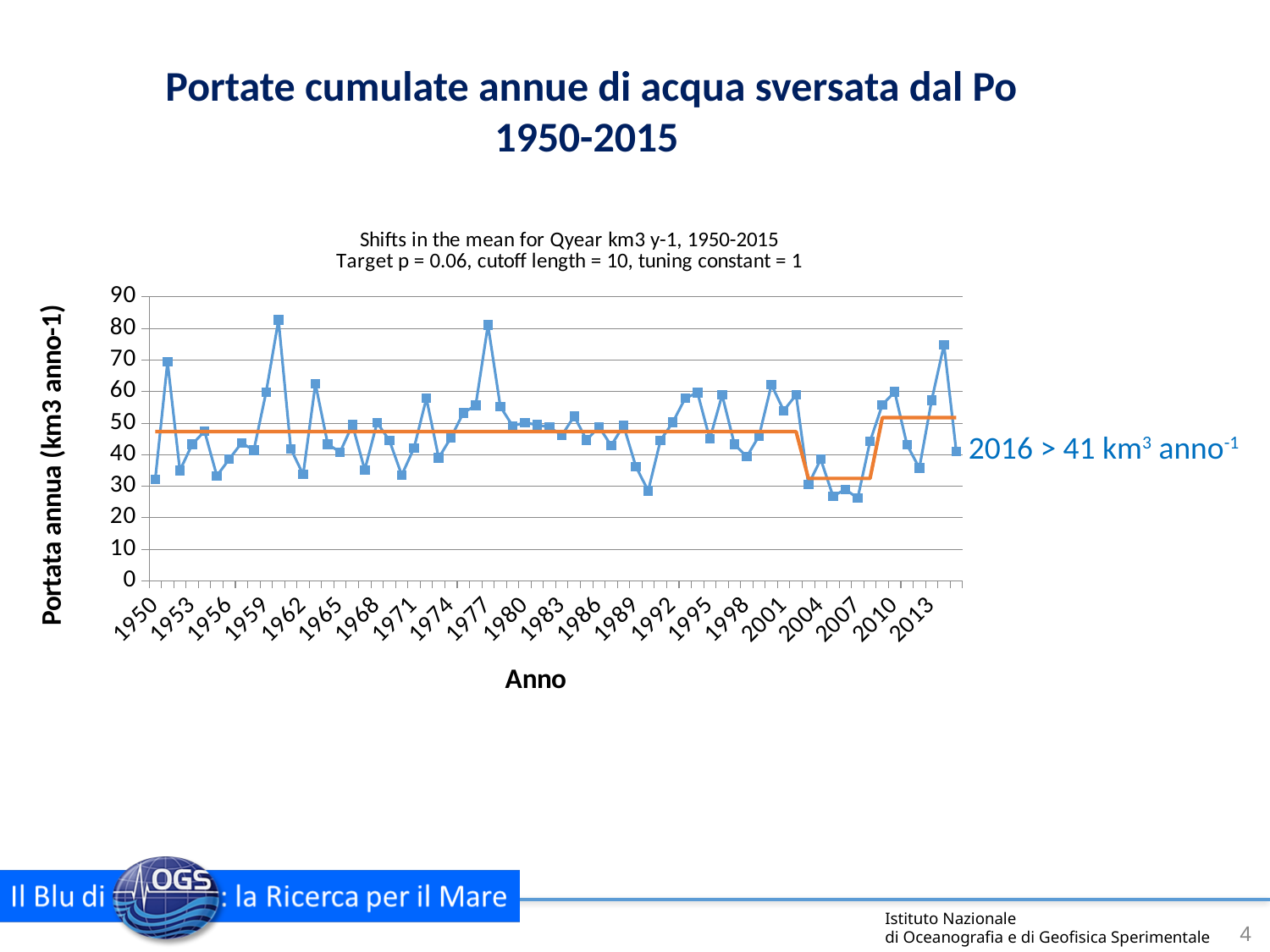
What is the label of the x axis of the chart? Anno What is the label of the y axis of the chart? Portata annua (km3 anno-1) Is the value for 2014 greater or less than 70? greater Which year has the larger value, 2014 or 2015? 2014 Which year has the larger value, 1960 or 2007? 1960 Is the value for 1951 greater or less than 60? greater What kind of chart is shown on the slide? line chart Is the value for 1950 greater or less than 40? less Which year has the larger value, 1950 or 1951? 1951